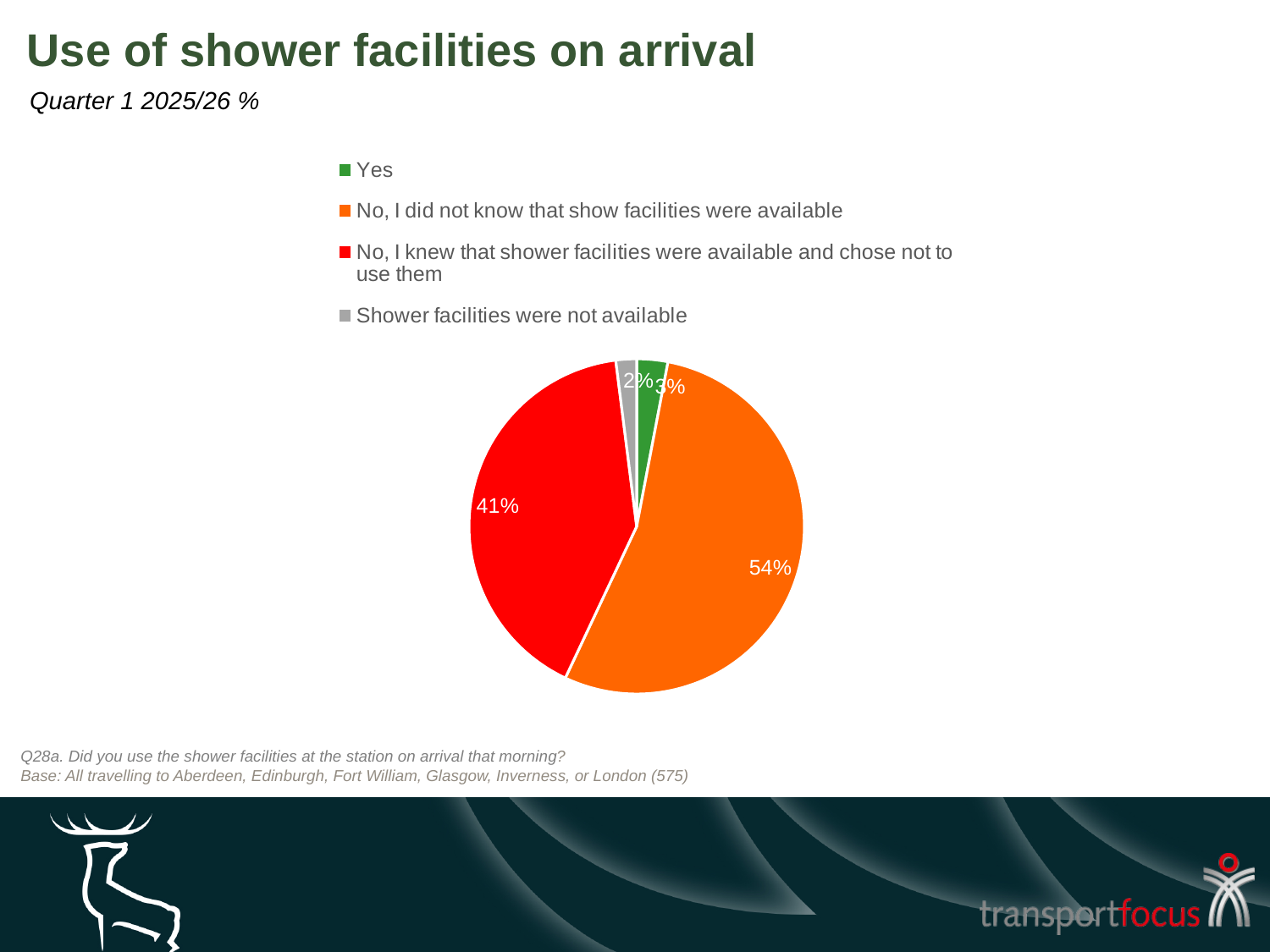
What kind of chart is shown on the slide? pie chart What colour is the slice for 'No, I knew that shower facilities were available and chose not to use them'? red What is the difference in percentage points between 'No, I did not know that show facilities were available' and 'No, I knew that shower facilities were available and chose not to use them'? 13 What percentage of respondents answered 'Yes'? 3% What percentage of respondents said 'No, I knew that shower facilities were available and chose not to use them'? 41% Which is larger: the share for 'Yes' or the share for 'Shower facilities were not available'? Yes Which response has the largest share of the pie? No, I did not know that show facilities were available Which response has the smallest share of the pie? Shower facilities were not available What percentage of respondents said 'Shower facilities were not available'? 2% What is the subtitle shown under the slide title? Quarter 1 2025/26 % What percentage of respondents said 'No, I did not know that show facilities were available'? 54% How many categories does the pie chart show? 4